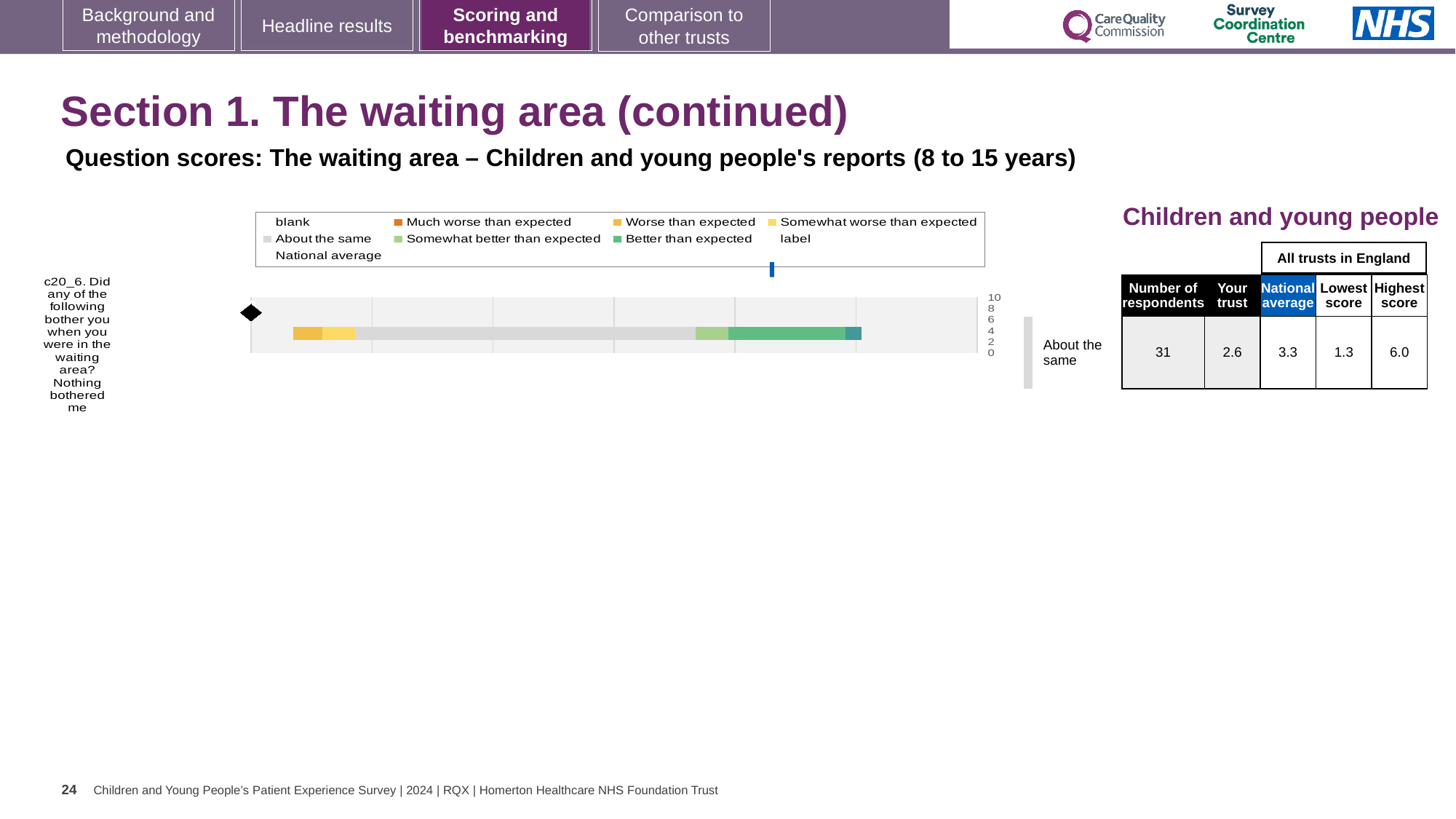
How many respondents answered question c20_6? 31 What is the national average score for question c20_6? 3.3 Which benchmark category label is shown to the right of the bar for question c20_6? About the same How many questions (categories) are plotted in the bar chart? 1 What is the highest score among all trusts in England for question c20_6? 6.0 How many entries does the chart legend list? 9 What is the 'Your trust' score for question c20_6 in the Children and young people table? 2.6 What is the lowest score among all trusts in England for question c20_6? 1.3 What is the difference between the highest score and the lowest score for question c20_6? 4.7 What is the difference between the national average and the 'Your trust' score for question c20_6? 0.7 Which is larger for question c20_6: the 'Your trust' score or the national average? National average What kind of chart is shown on the slide? bar chart